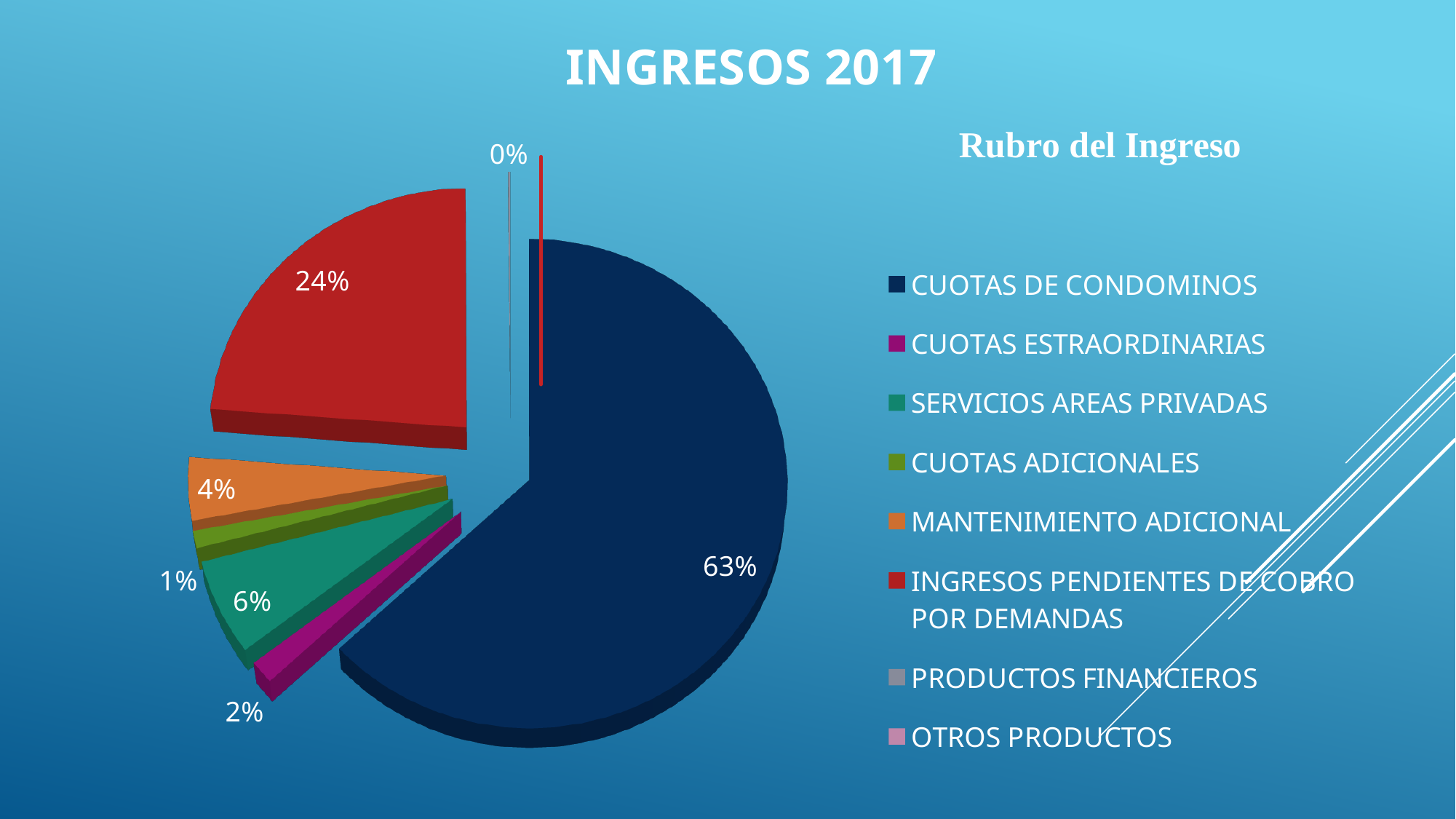
What percentage is shown for SERVICIOS AREAS PRIVADAS? 6% What percentage is shown for CUOTAS ESTRAORDINARIAS? 2% How many categories does the legend list? 8 How many percentage points larger is the CUOTAS DE CONDOMINOS slice than the INGRESOS PENDIENTES DE COBRO POR DEMANDAS slice? 39 percentage points Which is larger, the slice for SERVICIOS AREAS PRIVADAS or the slice for MANTENIMIENTO ADICIONAL? SERVICIOS AREAS PRIVADAS What percentage is shown for INGRESOS PENDIENTES DE COBRO POR DEMANDAS? 24% What percentage is shown for MANTENIMIENTO ADICIONAL? 4% Which category has the largest slice of the pie? CUOTAS DE CONDOMINOS What kind of chart is shown on the slide? Pie chart What percentage is shown for CUOTAS ADICIONALES? 1% What share of the pie does CUOTAS DE CONDOMINOS represent? 63% What is the title of the chart? INGRESOS 2017